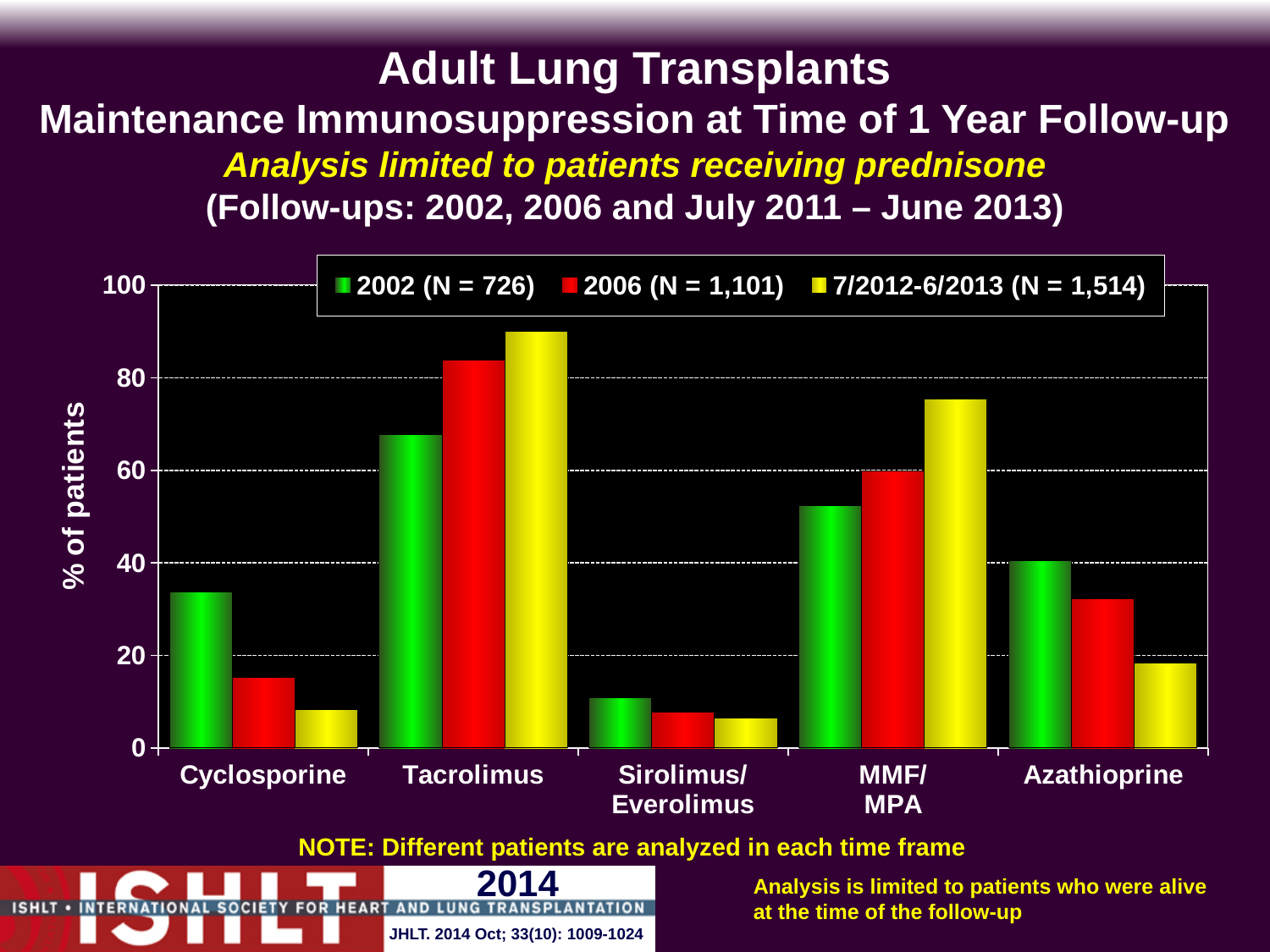
What kind of chart is shown on the slide? bar chart Which drug has the highest value for the 7/2012-6/2013 series? Tacrolimus Do the values for Tacrolimus rise or fall from 2002 to 7/2012-6/2013? rise For Azathioprine, which is larger: the 2002 value or the 7/2012-6/2013 value? 2002 How many series does the legend list? 3 How many drug categories are shown on the x axis? 5 Which drug has the lowest value for the 2002 series? Sirolimus/Everolimus Is the 7/2012-6/2013 value for MMF/MPA greater or less than 60? greater Do the values for Cyclosporine rise or fall from 2002 to 7/2012-6/2013? fall Is the 2002 value for Cyclosporine greater or less than 40? less Is the 2006 value for Tacrolimus greater or less than 80? greater What is the N shown in the legend for the 2006 series? 1,101